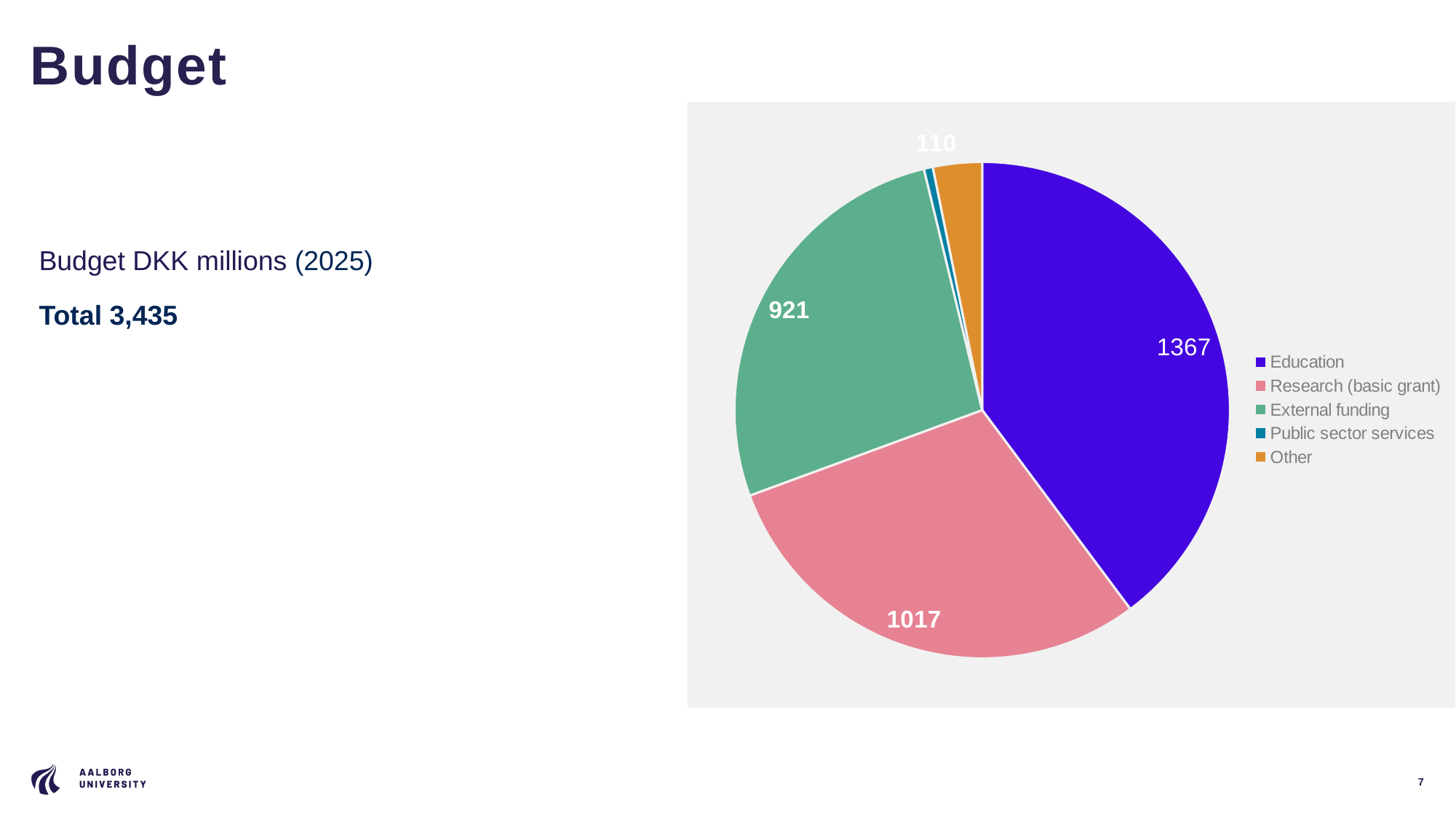
What is the value for Research (basic grant) in the pie chart? 1017 Which category has the smallest slice of the pie chart? Public sector services What is the difference between the values for Research (basic grant) and External funding? 96 Which is larger, External funding or Research (basic grant)? Research (basic grant) What is the difference between the values for Education and Research (basic grant)? 350 What is the value for External funding in the pie chart? 921 Which category has the largest slice of the pie chart? Education What is the value for Other in the pie chart? 110 How many categories does the pie chart show? 5 What is the value for Education in the pie chart? 1367 What kind of chart is shown on the slide? Pie chart What total budget is stated on the slide? 3,435